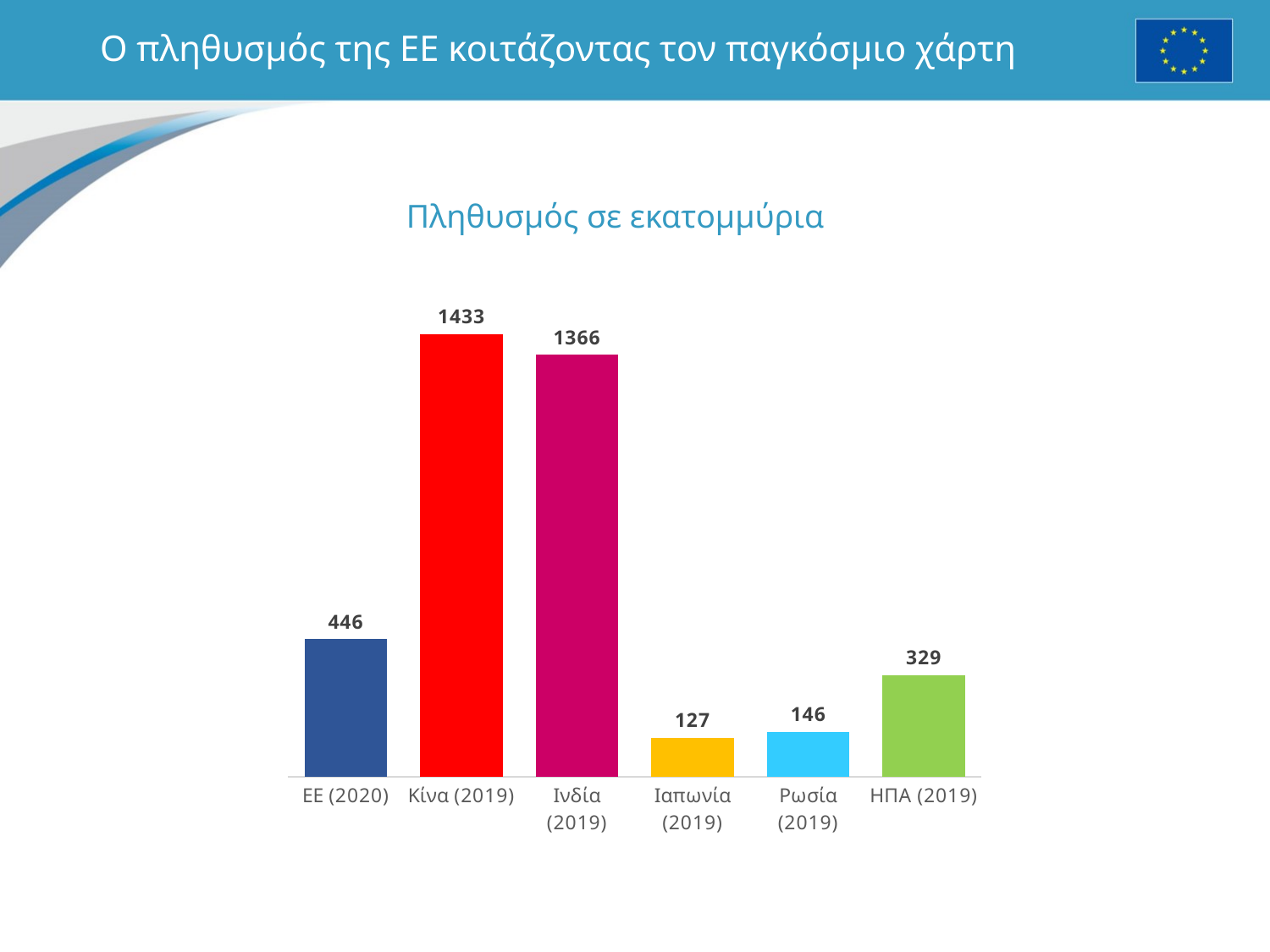
What is the population value shown for Κίνα (2019)? 1433 What is the difference between the values for Κίνα (2019) and Ινδία (2019)? 67 What is the population value shown for ΗΠΑ (2019)? 329 Which category has the highest population in the chart? Κίνα (2019) How many categories are shown in the chart? 6 What is the title of the chart? Πληθυσμός σε εκατομμύρια What kind of chart is shown on the slide? Bar chart What is the population value shown for ΕΕ (2020)? 446 What is the difference between the values for ΕΕ (2020) and ΗΠΑ (2019)? 117 Which category has the lowest population in the chart? Ιαπωνία (2019) Which is larger, the value for Ρωσία (2019) or the value for Ιαπωνία (2019)? Ρωσία (2019) What is the population value shown for Ιαπωνία (2019)? 127